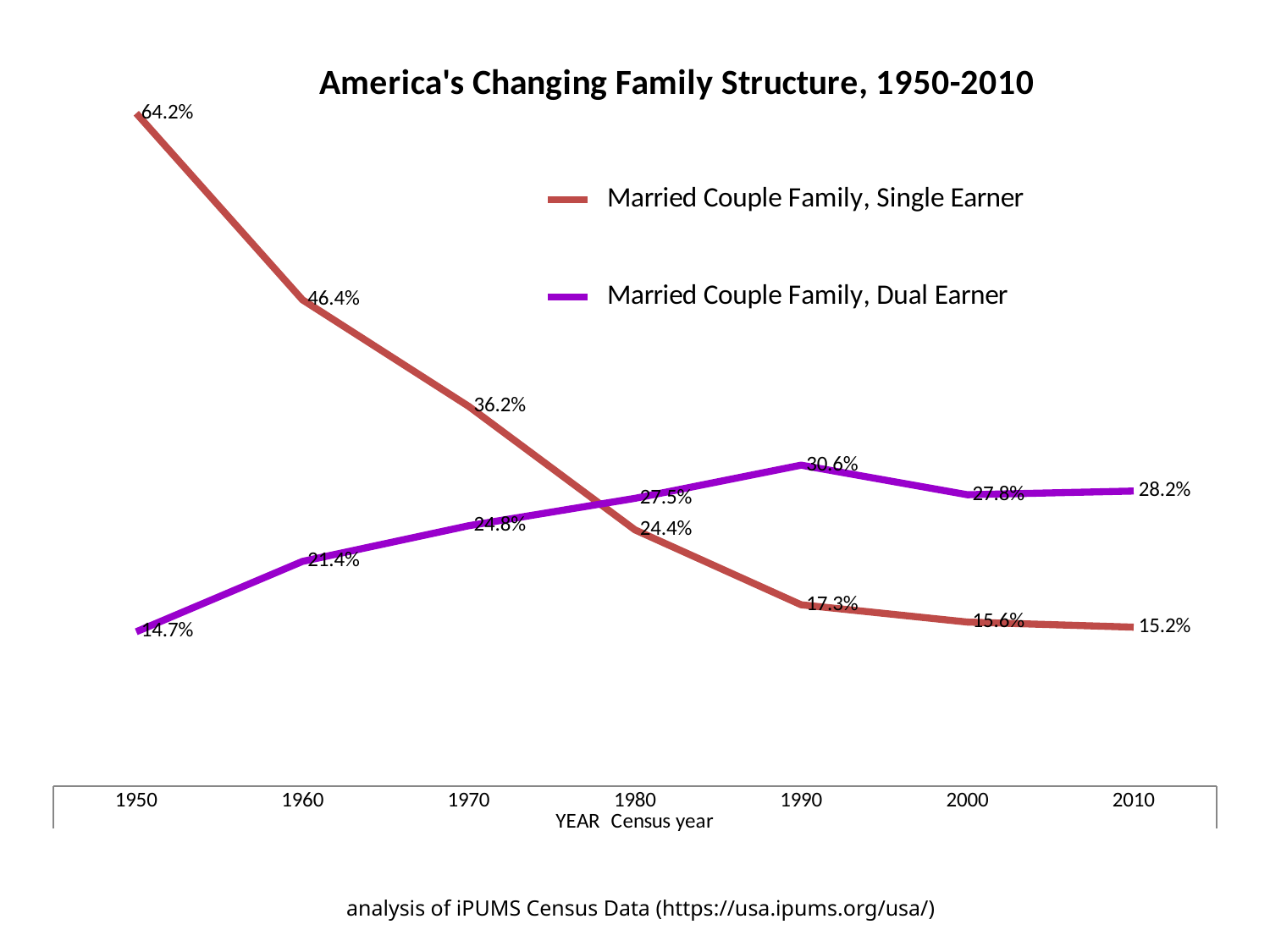
What was the value for Married Couple Family, Dual Earner in 2010? 28.2% What was the value for Married Couple Family, Single Earner in 1950? 64.2% Which series had the larger value in 1970, Single Earner or Dual Earner? Married Couple Family, Single Earner In which year was the Married Couple Family, Single Earner series at its lowest? 2010 What was the value for Married Couple Family, Dual Earner in 1990? 30.6% How many census years are plotted on the x axis? 7 How many series does the legend list? 2 In which year was the Married Couple Family, Dual Earner series at its highest? 1990 Does the Married Couple Family, Single Earner series rise or fall from 1950 to 2010? Fall What is the difference between the Single Earner value in 1950 and the Single Earner value in 2010? 49.0% What was the value for Married Couple Family, Single Earner in 1980? 24.4% What kind of chart is shown on the slide? Line chart